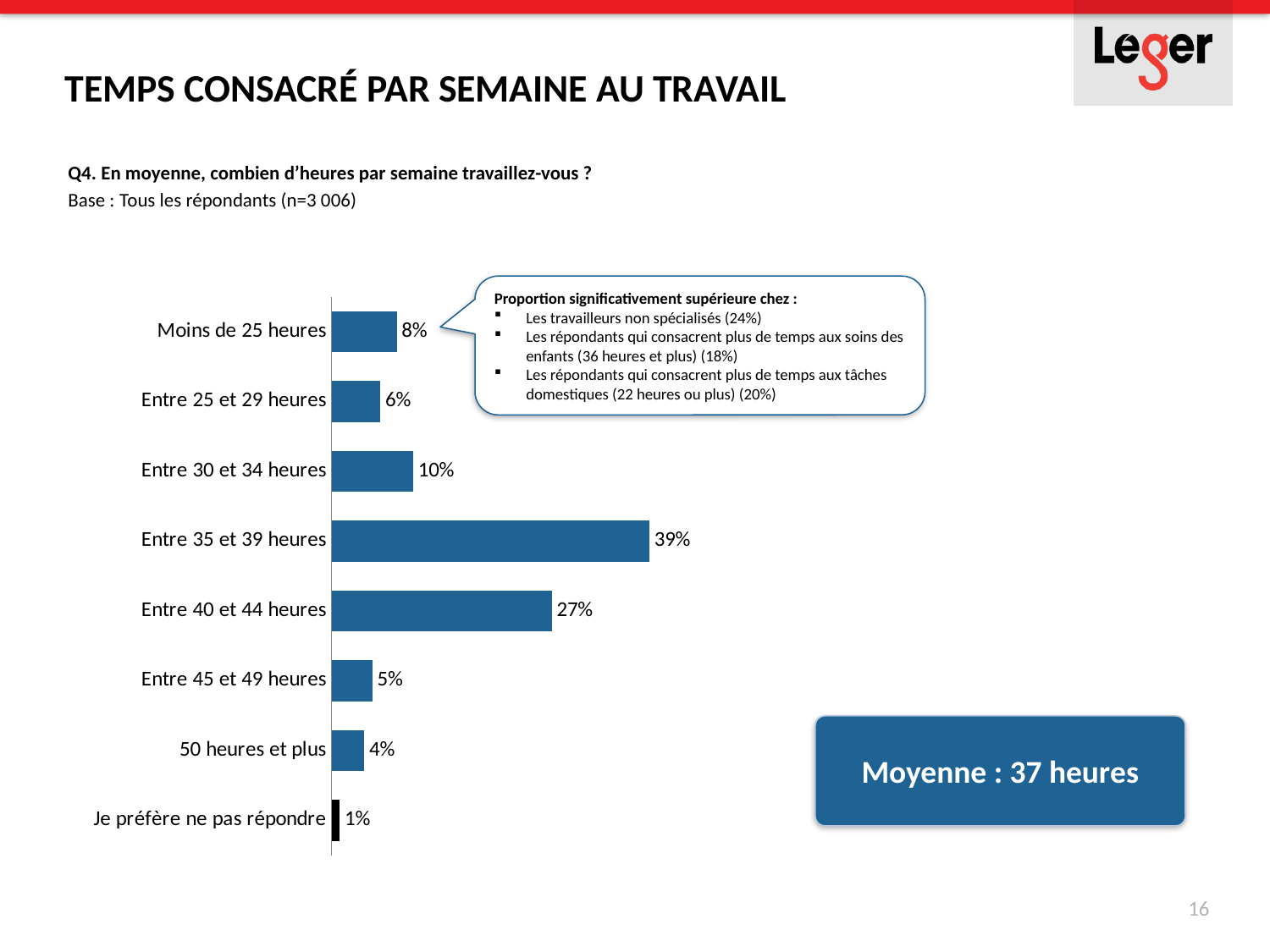
What is the value for "Je préfère ne pas répondre"? 1% What average number of hours is stated in the box next to the chart? 37 heures What is the value for "Entre 40 et 44 heures"? 27% What is the value for "Moins de 25 heures"? 8% What is the difference between the values for "Entre 45 et 49 heures" and "50 heures et plus"? 1% What is the difference between the values for "Entre 35 et 39 heures" and "Entre 40 et 44 heures"? 12% How many categories are shown in the chart? 8 Which category has the highest value? Entre 35 et 39 heures Which category has the lowest value? Je préfère ne pas répondre What kind of chart is shown on the slide? Bar chart What is the value for "Entre 35 et 39 heures"? 39% Which is larger, the value for "Entre 30 et 34 heures" or the value for "Entre 25 et 29 heures"? Entre 30 et 34 heures